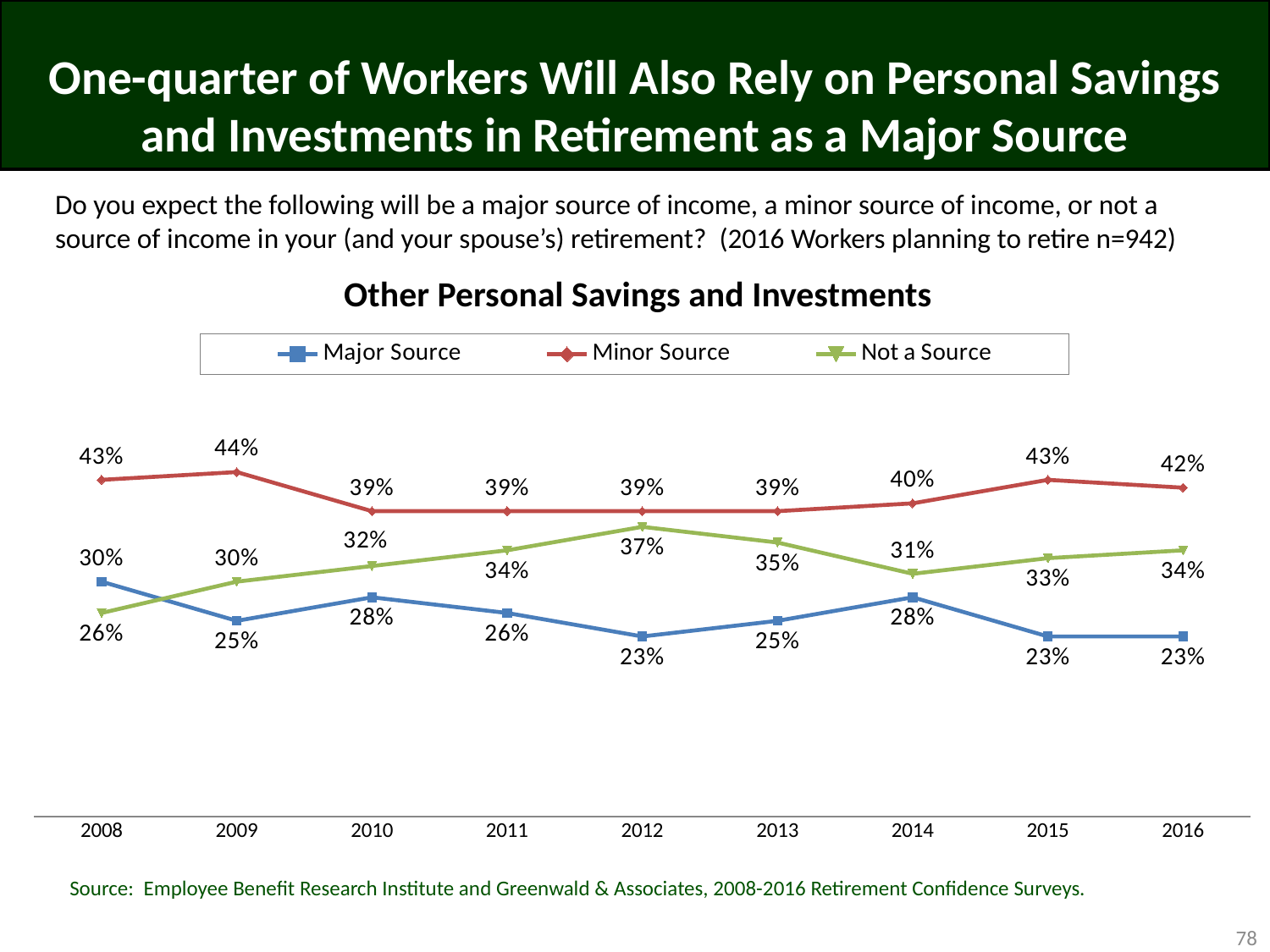
In which year is the Not a Source value lowest? 2008 What is the difference between the Minor Source and Major Source values in 2016? 19% What type of chart is shown on the slide? line chart Does the Not a Source line rise or fall from 2008 to 2012? rise What is the value for Not a Source in 2012? 37% How many years are shown on the x axis? 9 What is the value for Major Source in 2016? 23% In 2008, which is larger: Major Source or Not a Source? Major Source In which year is the Minor Source value highest? 2009 How many series does the legend list? 3 What is the value for Minor Source in 2009? 44% What is the title of the chart? Other Personal Savings and Investments